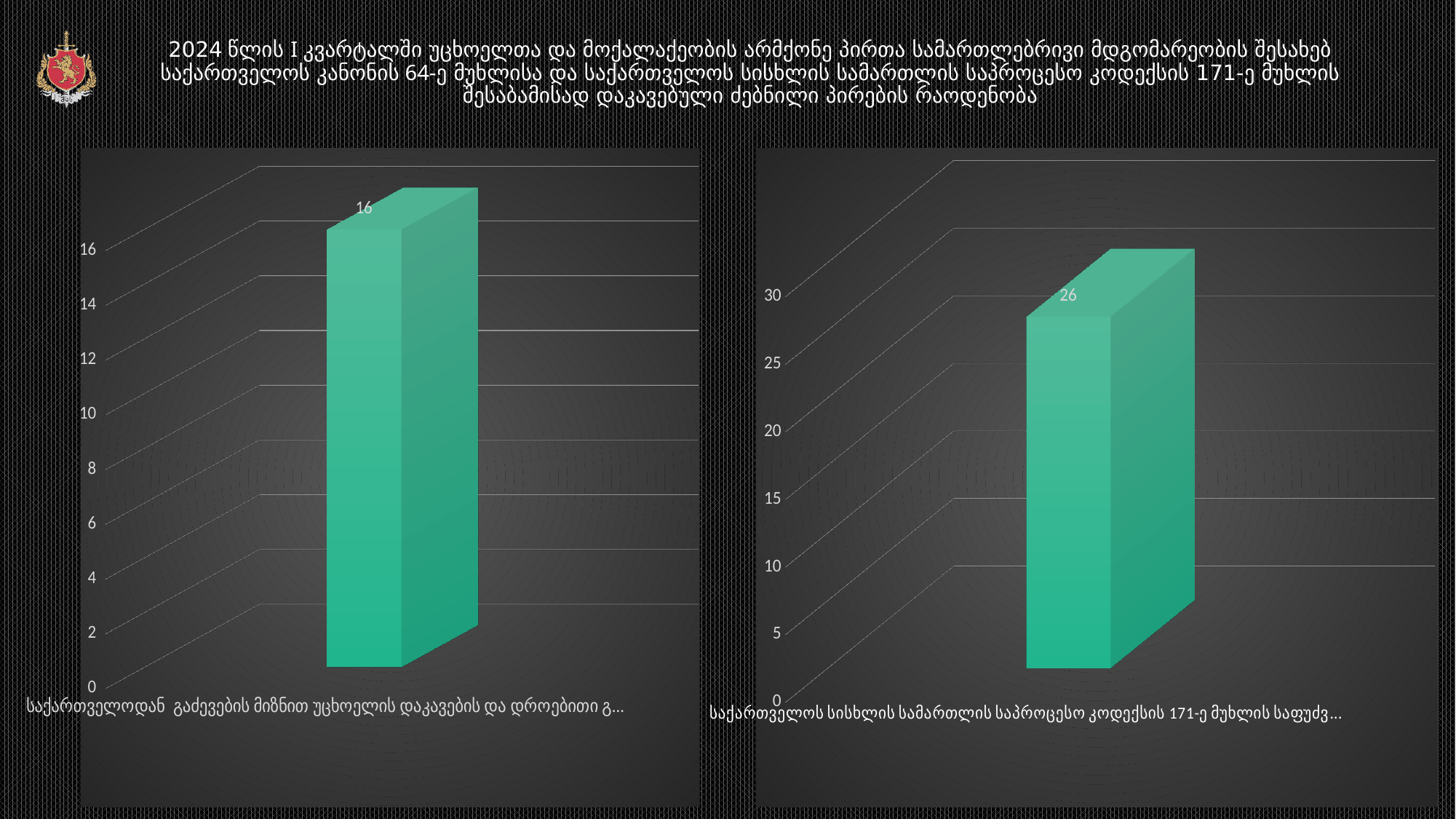
How many bars are plotted on the right chart? 1 What is the highest tick label shown on the vertical axis of the right chart? 30 What kind of chart is the left chart? bar chart What kind of chart is the right chart? bar chart On the left chart, is the value of the bar greater or less than 10? greater How many bars are plotted on the left chart? 1 What colour are the bars on the two charts? green Which chart shows the larger bar value, the left chart or the right chart? the right chart On the right chart, is the value of the bar greater or less than 20? greater On the left chart, what value is printed on the bar? 16 What is the difference between the bar value on the right chart and the bar value on the left chart? 10 On the right chart, what value is printed on the bar? 26